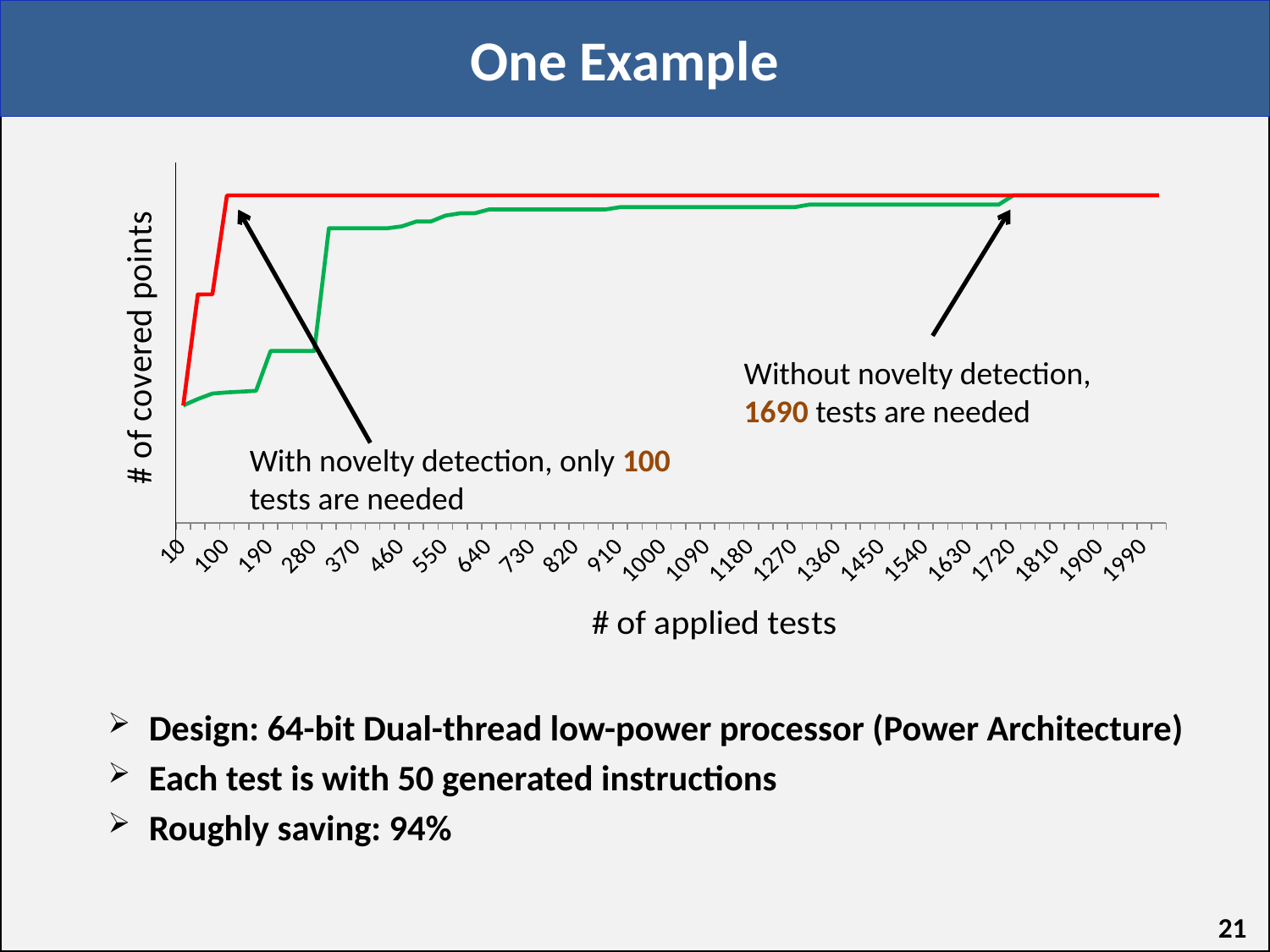
Does the number of covered points rise or fall as the number of applied tests increases? rise How many tick labels are shown on the x axis? 23 According to the annotation, how many tests are needed with novelty detection? 100 Which needs more tests to reach full coverage: with novelty detection or without novelty detection? without novelty detection According to the annotation, how many tests are needed without novelty detection? 1690 What kind of chart is shown on the slide? line chart What is the largest tick label shown on the x axis? 1990 Which line reaches its plateau first, the red line or the green line? the red line What is the label of the x axis? # of applied tests What is the difference between the number of tests needed without novelty detection and with novelty detection? 1590 How many lines are plotted on the chart? 2 What is the label of the y axis? # of covered points